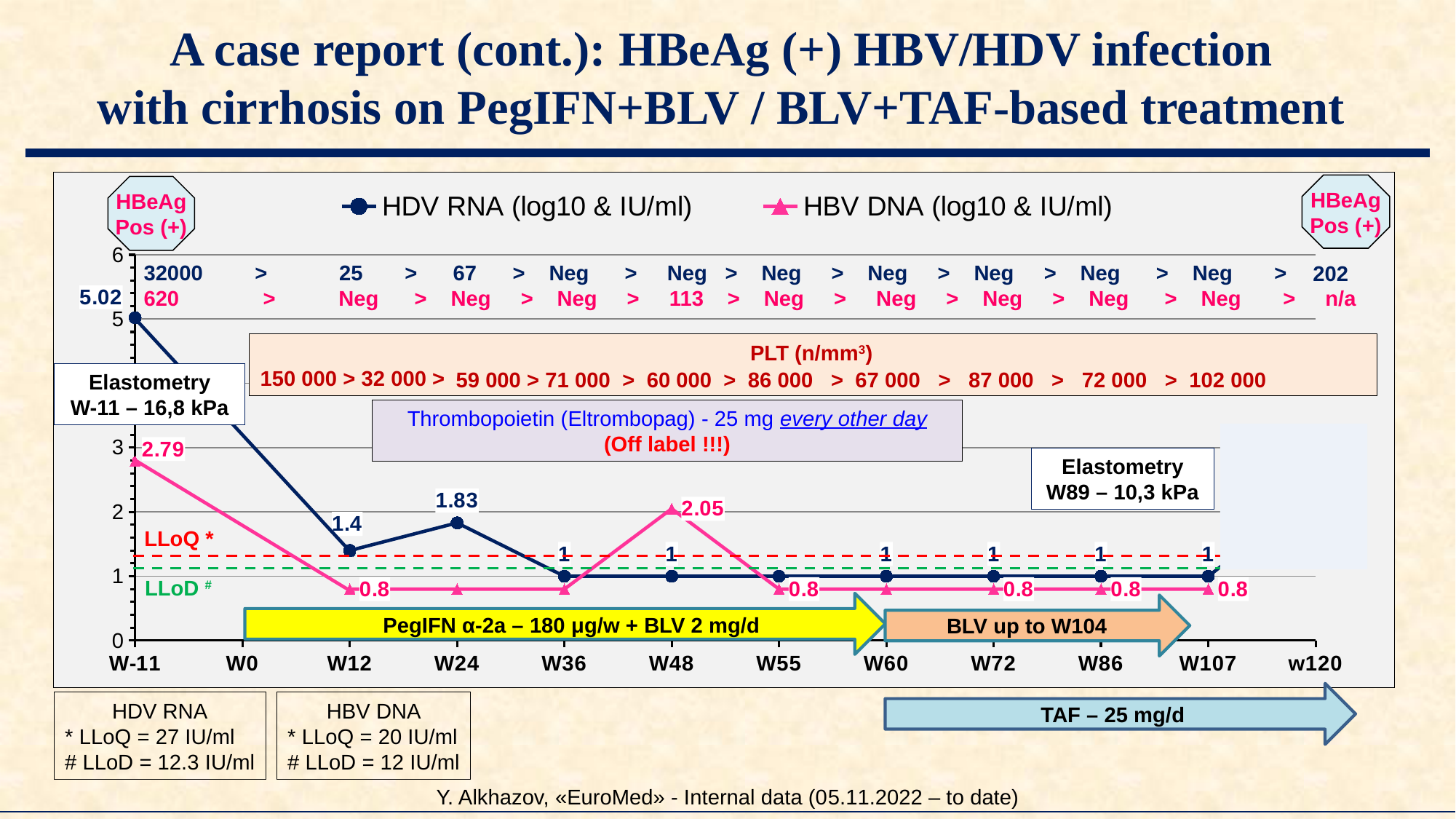
What is the HBV DNA value at W48? 2.05 How many series does the chart legend list? 2 Which is larger at W48, the HDV RNA value or the HBV DNA value? HBV DNA What is the HDV RNA value at W12? 1.4 What type of chart is shown on the slide? line chart Is the HDV RNA value at W-11 greater or less than 4? greater What is the HDV RNA value at W-11? 5.02 At which time point is the HDV RNA value highest? W-11 What is the difference between the HDV RNA value at W-11 and at W12? 3.62 What is the HBV DNA value at W-11? 2.79 What is the HDV RNA value at W24? 1.83 Does the HDV RNA series rise or fall from W-11 to W36? fall